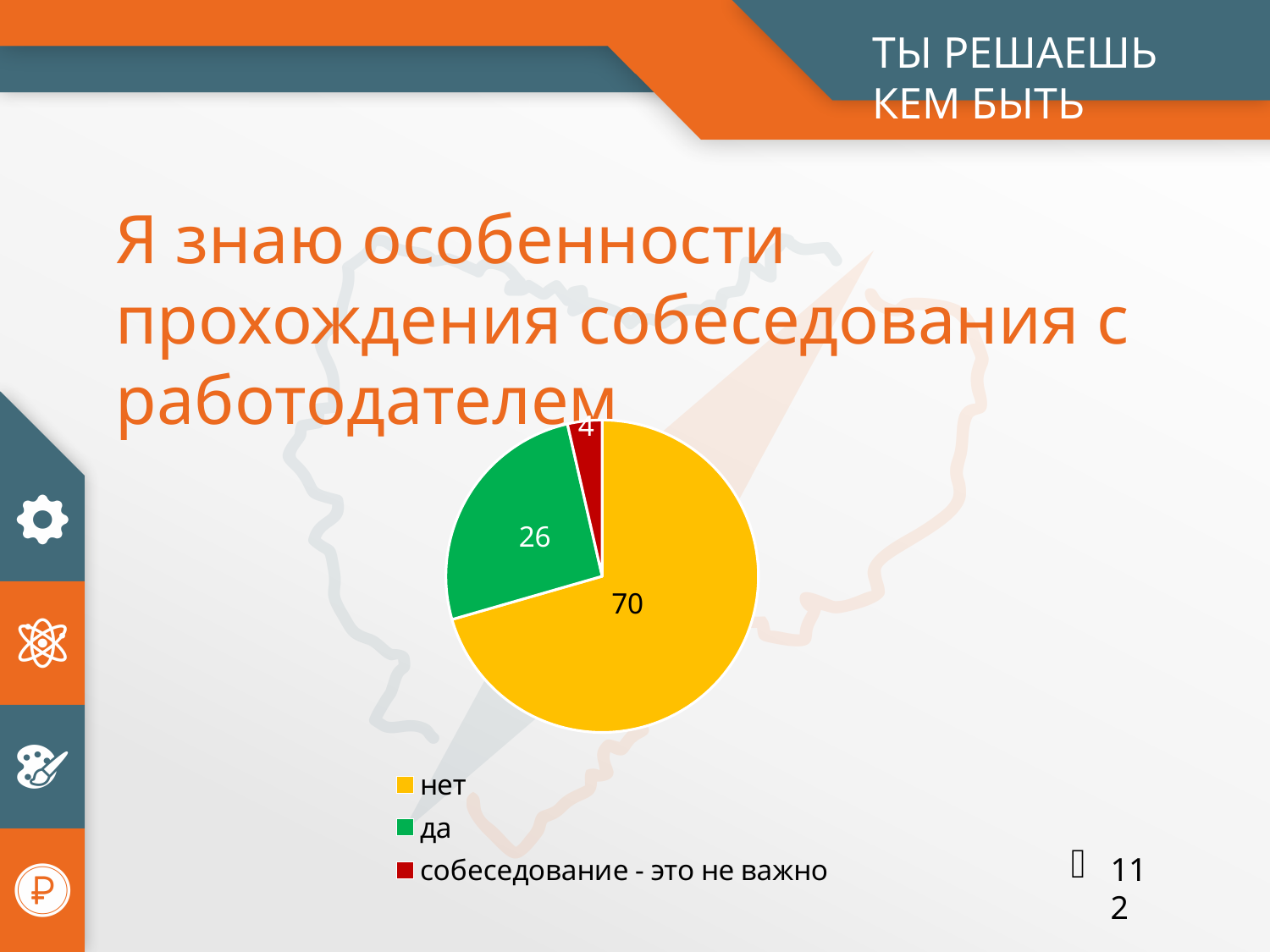
What is the difference between the values for "нет" and "да"? 44 What is the value for the "собеседование - это не важно" slice? 4 What is the difference between the values for "да" and "собеседование - это не важно"? 22 Which category has the largest slice of the pie? нет Which category has the smallest slice of the pie? собеседование - это не важно How many slices does the pie chart have? 3 What share of the pie does the "нет" slice represent? 70% What is the value for the "да" slice? 26 What is the value for the "нет" slice? 70 What colour is the "да" slice in the pie chart? green What type of chart is shown on the slide? pie chart Which is larger, the value for "да" or the value for "собеседование - это не важно"? да